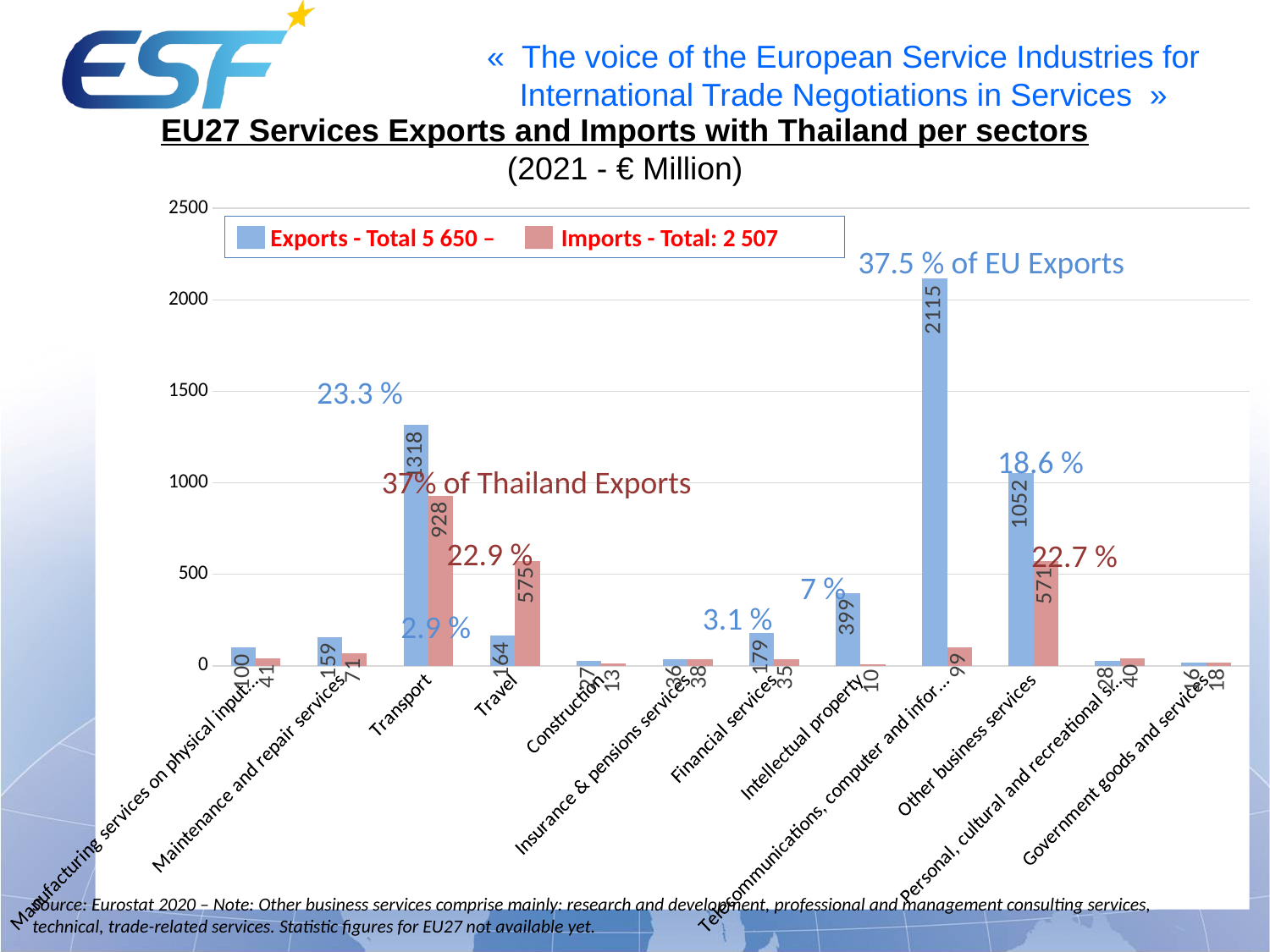
How many series does the legend list? 2 What is the difference between Exports and Imports for Transport? 390 What is the Exports value for Transport? 1318 Is the Exports value for Intellectual property greater or less than 500? less How many sectors are shown on the x axis? 12 For Travel, which is larger: Exports or Imports? Imports Which sector has the highest Imports value? Transport What kind of chart is shown on the slide? Bar chart Which sector has the highest Exports value? Telecommunications, computer and infor... What is the Exports value for Other business services? 1052 What is the Imports value for Travel? 575 Which sector has the lowest Exports value? Government goods and services